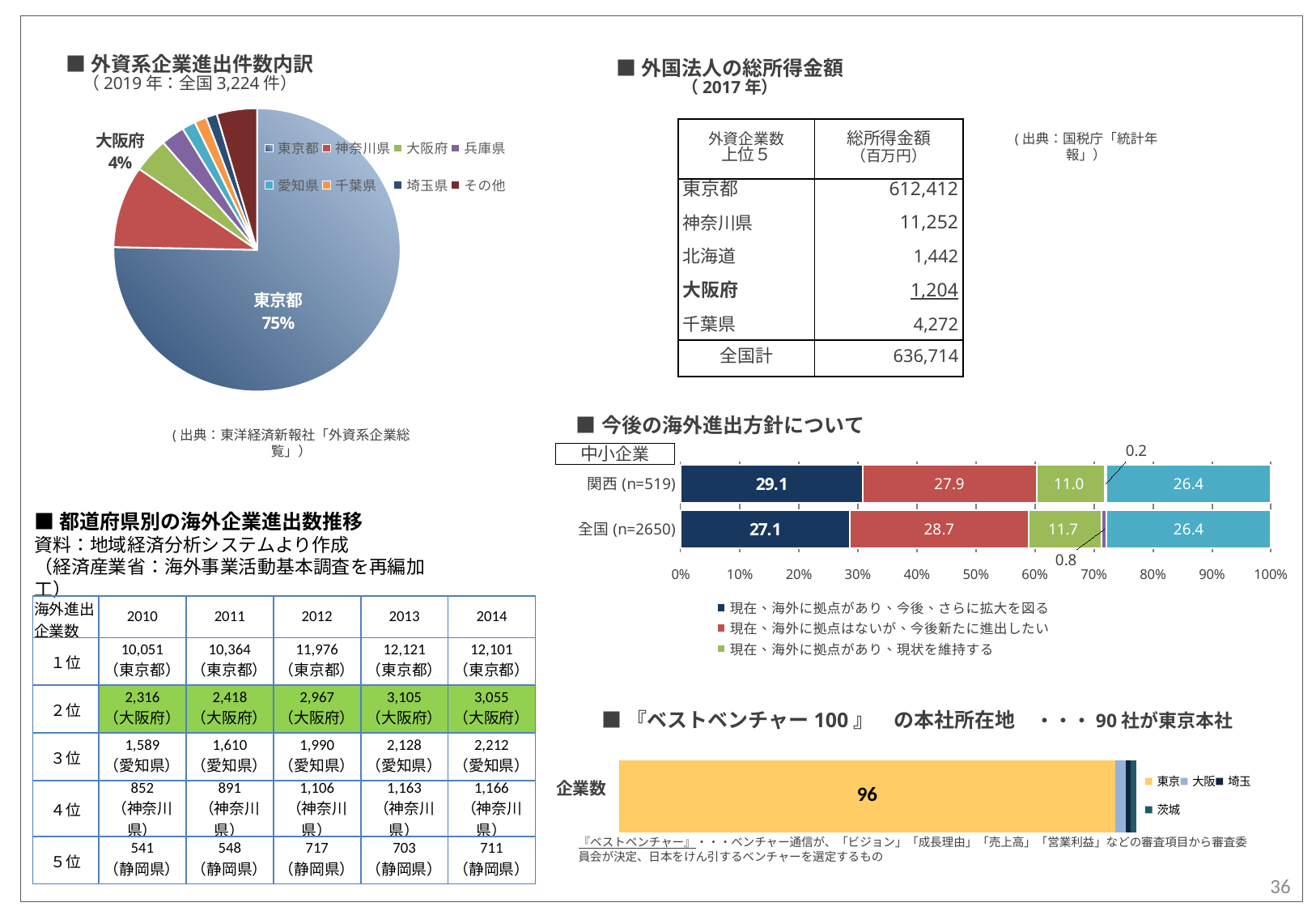
In the 今後の海外進出方針について chart, what is the value of the red segment (現在、海外に拠点はないが、今後新たに進出したい) for 全国 (n=2650)? 28.7 How many entries does the legend of the ベストベンチャー100 の本社所在地 chart list? 4 In the pie chart 外資系企業進出件数内訳, which category has the largest slice? 東京都 What kind of chart is the 外資系企業進出件数内訳 chart? pie chart In the ベストベンチャー100 の本社所在地 chart, what is the value shown for 東京? 96 In the pie chart 外資系企業進出件数内訳, what share does 大阪府 have? 4% What kind of chart is the 今後の海外進出方針について chart? bar chart In the 今後の海外進出方針について chart, which bar has the larger green segment (現在、海外に拠点があり、現状を維持する), 関西 or 全国? 全国 In the pie chart 外資系企業進出件数内訳, what share does 東京都 have? 75% How many entries does the legend of the pie chart 外資系企業進出件数内訳 list? 8 In the 今後の海外進出方針について chart, what is the difference between the dark blue segment values for 関西 (29.1) and 全国 (27.1)? 2.0 In the 今後の海外進出方針について chart, what is the value of the dark blue segment (現在、海外に拠点があり、今後、さらに拡大を図る) for 関西 (n=519)? 29.1